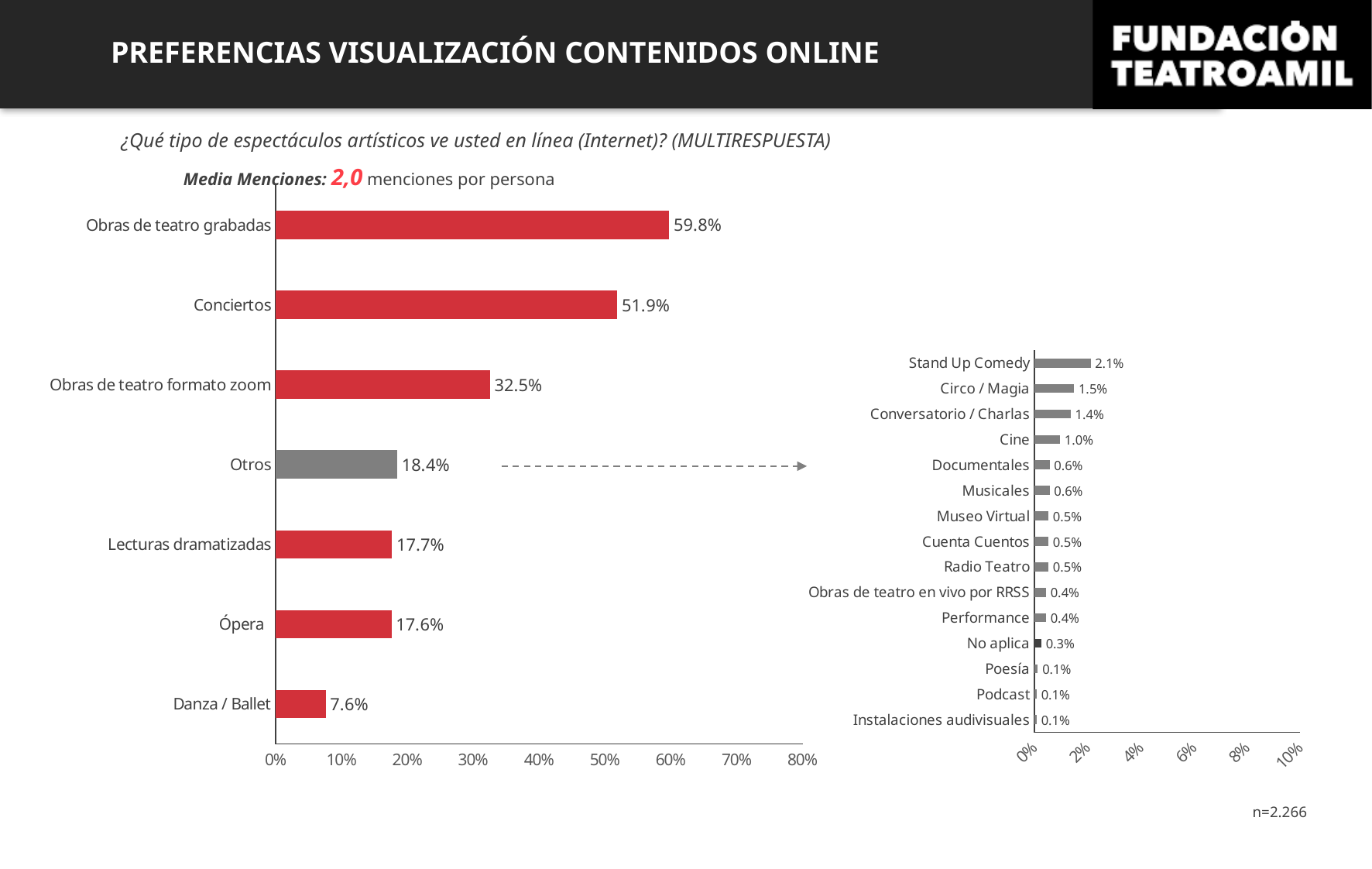
In the left chart, which bar is coloured grey instead of red? Otros How many categories are shown in the left chart? 7 In the left chart, which category has the lowest value? Danza / Ballet In the right chart, which category has the highest value? Stand Up Comedy What kind of chart is the left chart? Bar chart In the right chart, what is the value for Stand Up Comedy? 2.1% In the left chart, what is the value for Obras de teatro grabadas? 59.8% How many categories are shown in the right chart? 15 In the left chart, what is the difference between Obras de teatro grabadas and Conciertos? 7.9% In the right chart, what is the value for Cine? 1.0% In the left chart, what is the value for Conciertos? 51.9% In the left chart, which is larger: Obras de teatro formato zoom or Otros? Obras de teatro formato zoom